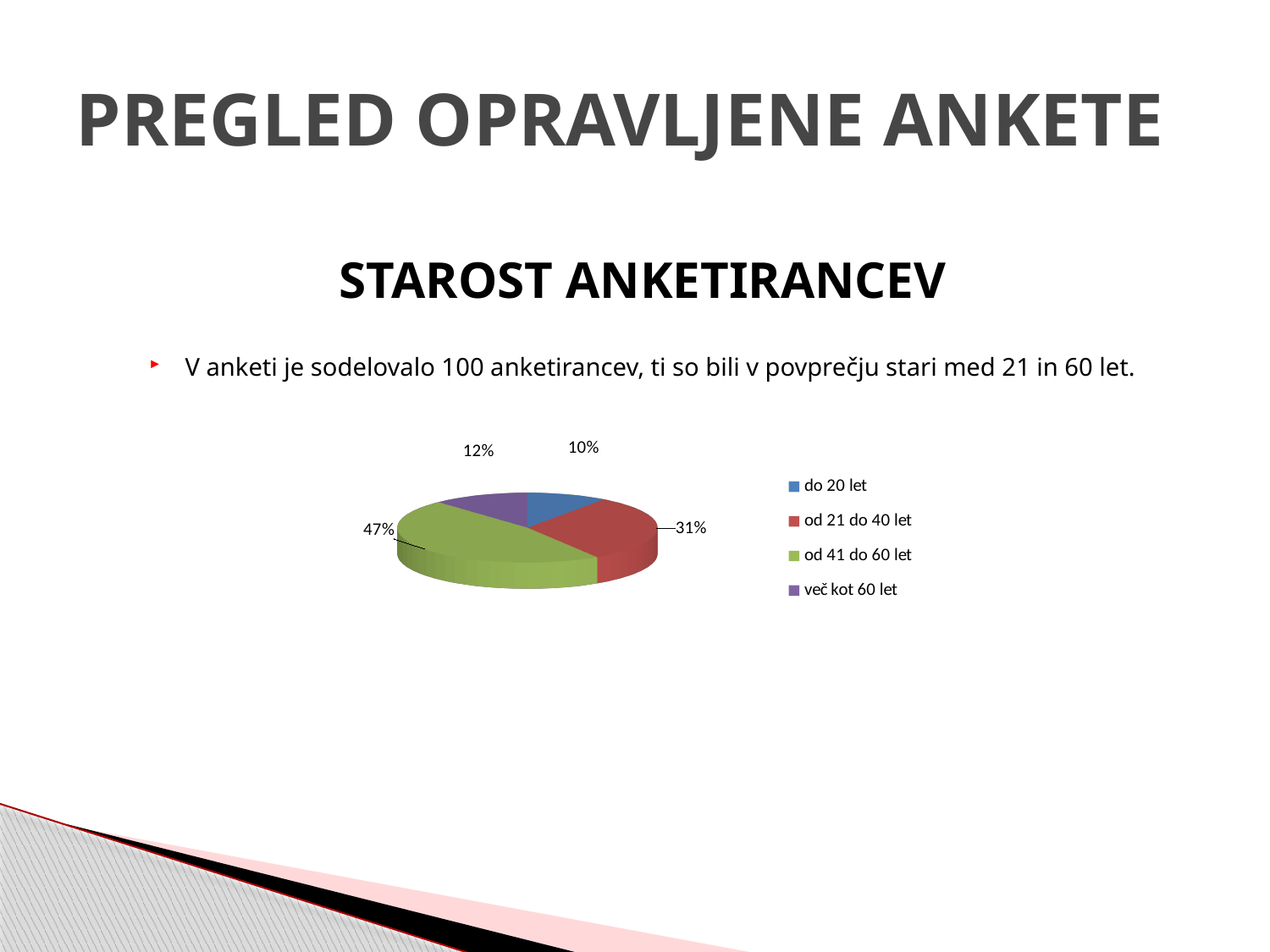
Which age group has the largest share of the pie? od 41 do 60 let What colour is the "od 21 do 40 let" slice in the pie chart? red What share of the pie does the "več kot 60 let" slice have? 12% How many slices does the pie chart have? 4 How many entries does the legend list? 4 Which age group has the smallest share of the pie? do 20 let What share of the pie does the "od 41 do 60 let" slice have? 47% Which slice is larger, "več kot 60 let" or "do 20 let"? več kot 60 let What kind of chart is shown on the slide? pie chart What is the difference in percentage points between the "od 41 do 60 let" and "od 21 do 40 let" slices? 16% What share of the pie does the "do 20 let" slice have? 10%